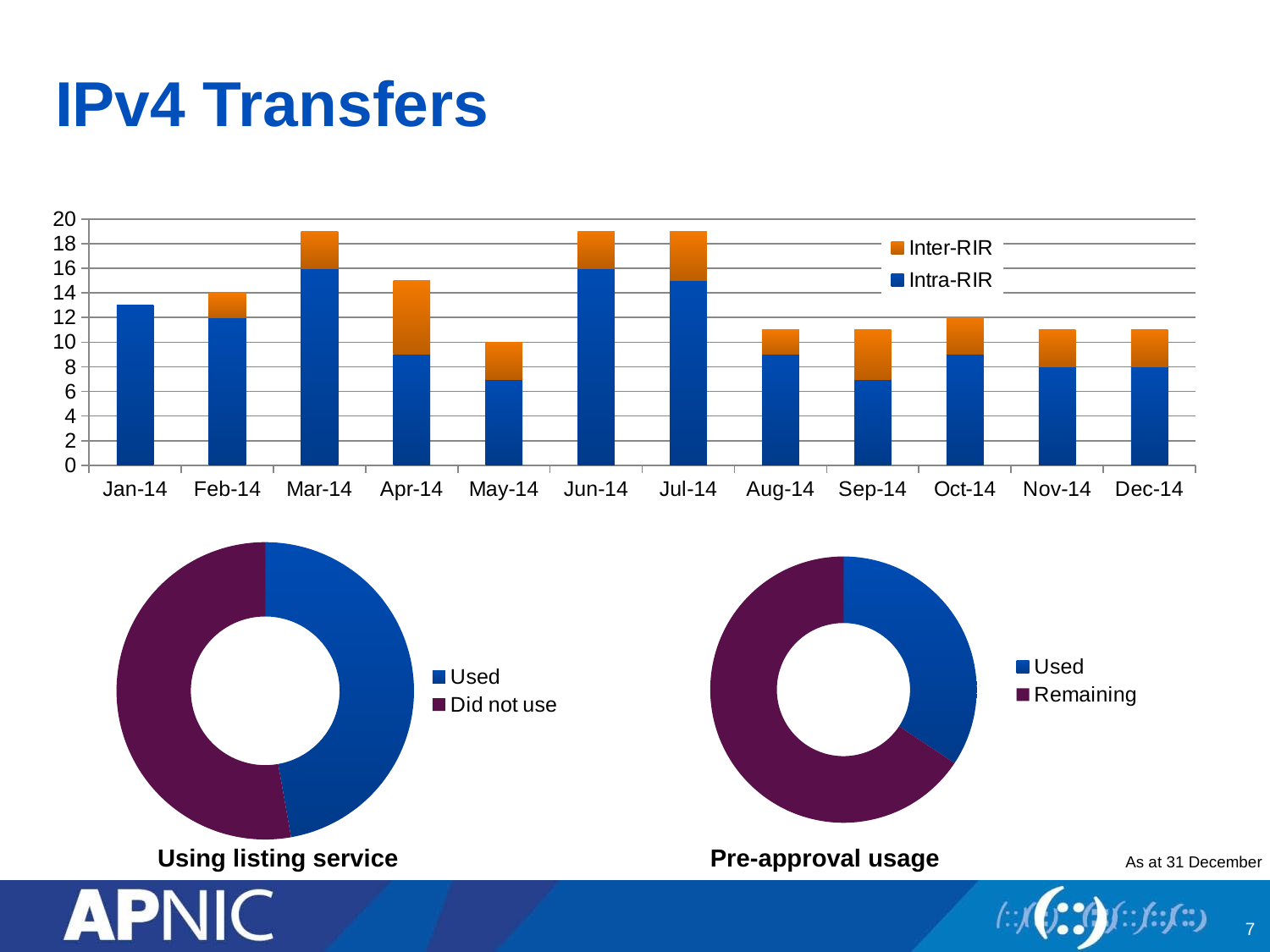
In the top bar chart, is the Intra-RIR value for Jun-14 greater or less than 14? greater In the 'Pre-approval usage' chart, which slice is larger, Used or Remaining? Remaining In the top bar chart, which month has the larger total, Mar-14 or May-14? Mar-14 What kind of chart is the top chart showing monthly IPv4 transfers? Stacked bar chart How many series does the legend of the top bar chart list? 2 In the top bar chart, is the total for Mar-14 greater or less than 18? greater What kind of chart is the 'Pre-approval usage' chart? Doughnut chart How many months are shown on the x axis of the top bar chart? 12 In the top bar chart, which series is shown in orange? Inter-RIR What are the two legend entries of the 'Using listing service' chart? Used, Did not use In the top bar chart, is the total for May-14 greater or less than 12? less In the top bar chart, which month has the larger Inter-RIR segment, Apr-14 or Feb-14? Apr-14